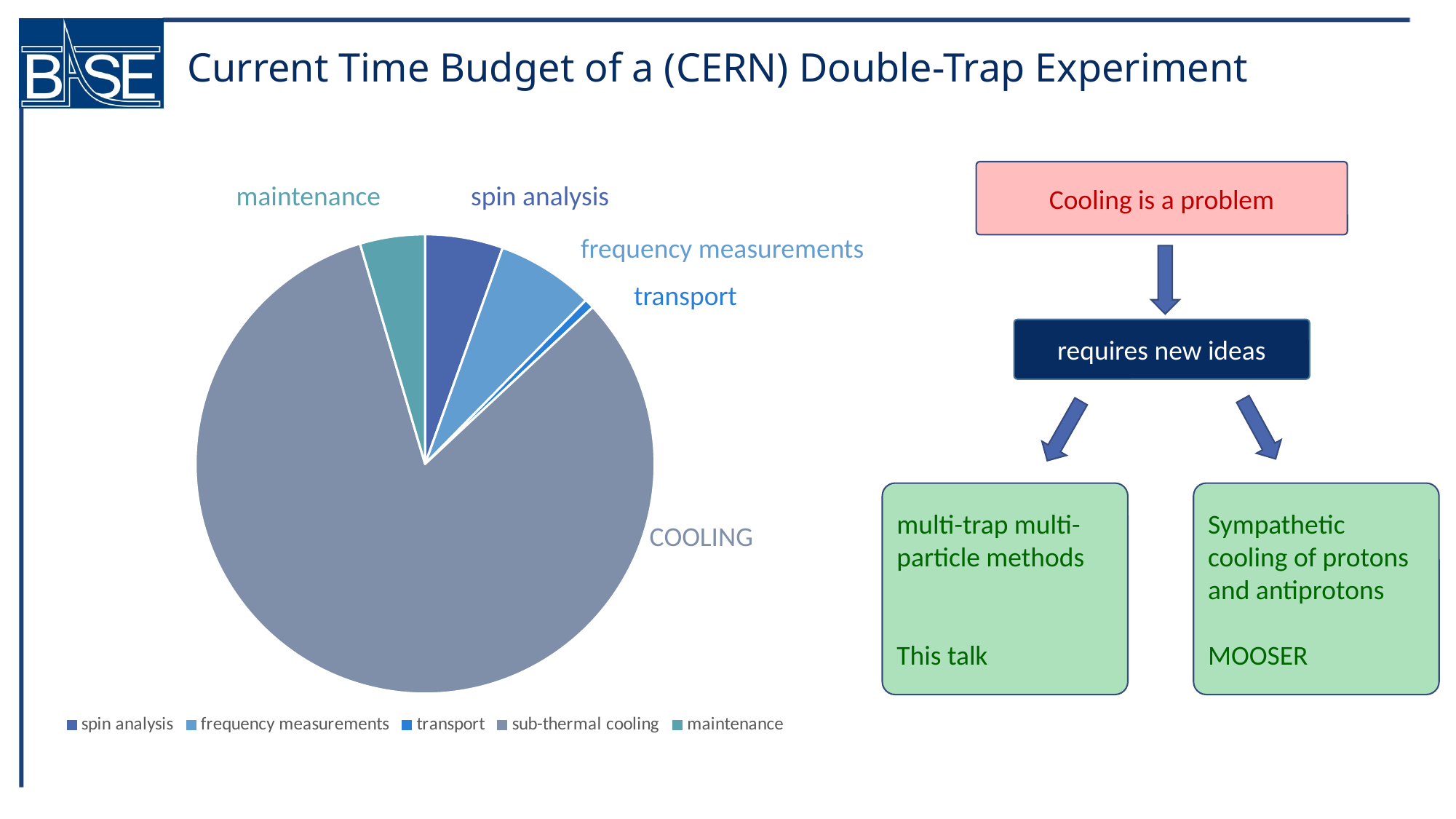
Which slice is larger, frequency measurements or transport? frequency measurements Which slice is larger, spin analysis or transport? spin analysis Which slice is larger, COOLING or maintenance? COOLING What kind of chart is shown on the slide? pie chart Which category takes the smallest share of the pie chart? transport How many slices does the pie chart have? 5 Which category takes the largest share of the pie chart? COOLING What legend entry corresponds to the slice labelled COOLING on the pie chart? sub-thermal cooling How many entries does the legend of the pie chart list? 5